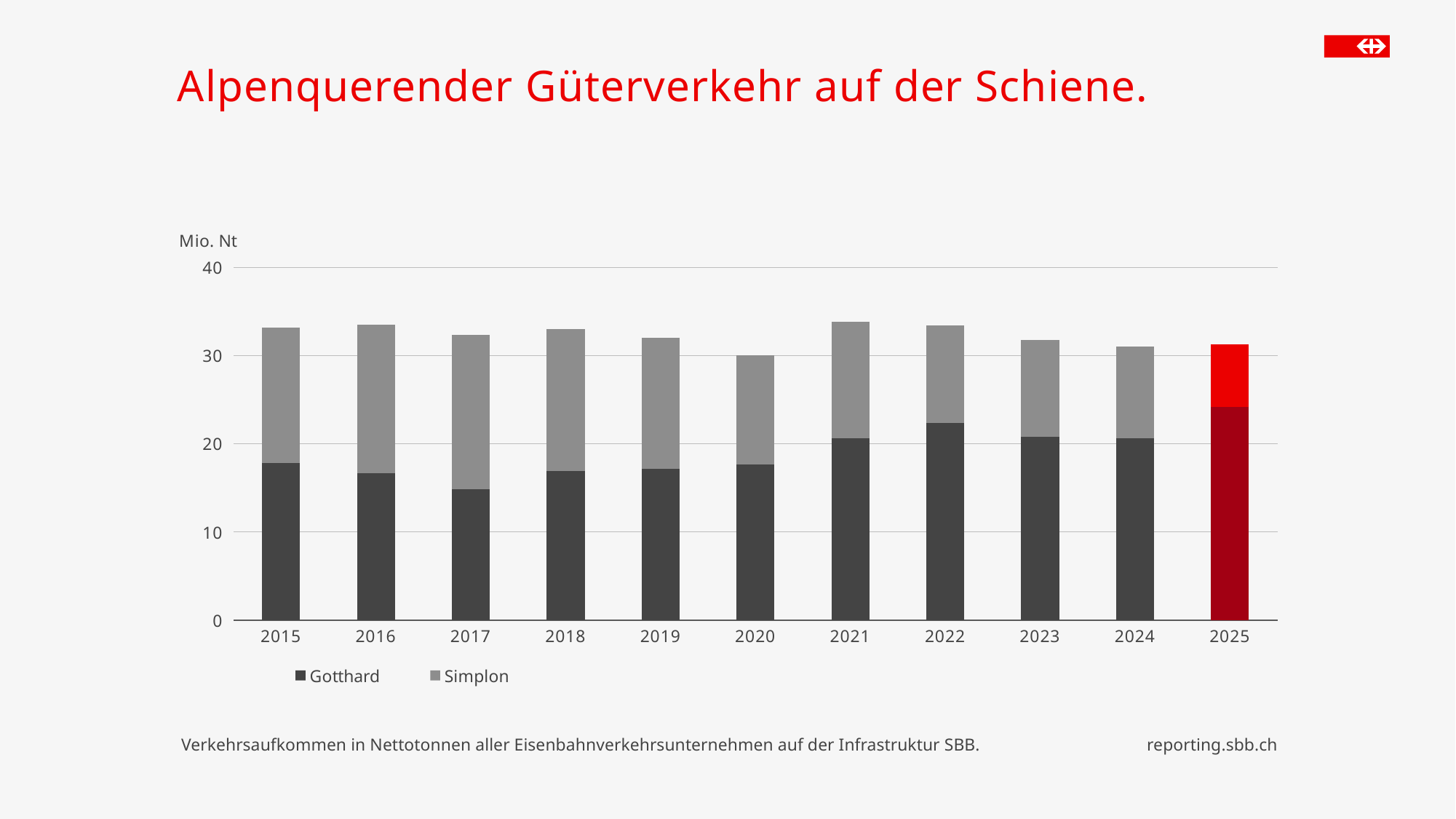
In which year is the Gotthard value the lowest? 2017 Which is larger, the Simplon value for 2017 or the Simplon value for 2025? 2017 How many years are shown on the x axis of the chart? 11 What is the title of the slide? Alpenquerender Güterverkehr auf der Schiene. In which year is the Gotthard value the highest? 2025 How many series does the chart legend list? 2 Does the Gotthard value rise or fall from 2017 to 2022? rise Which two series are listed in the chart legend? Gotthard and Simplon Is the Gotthard value for 2017 greater or less than 20? less Is the Gotthard value for 2022 greater or less than 20? greater What kind of chart is shown on the slide? Stacked bar chart Is the total stacked value for 2021 greater or less than 30? greater